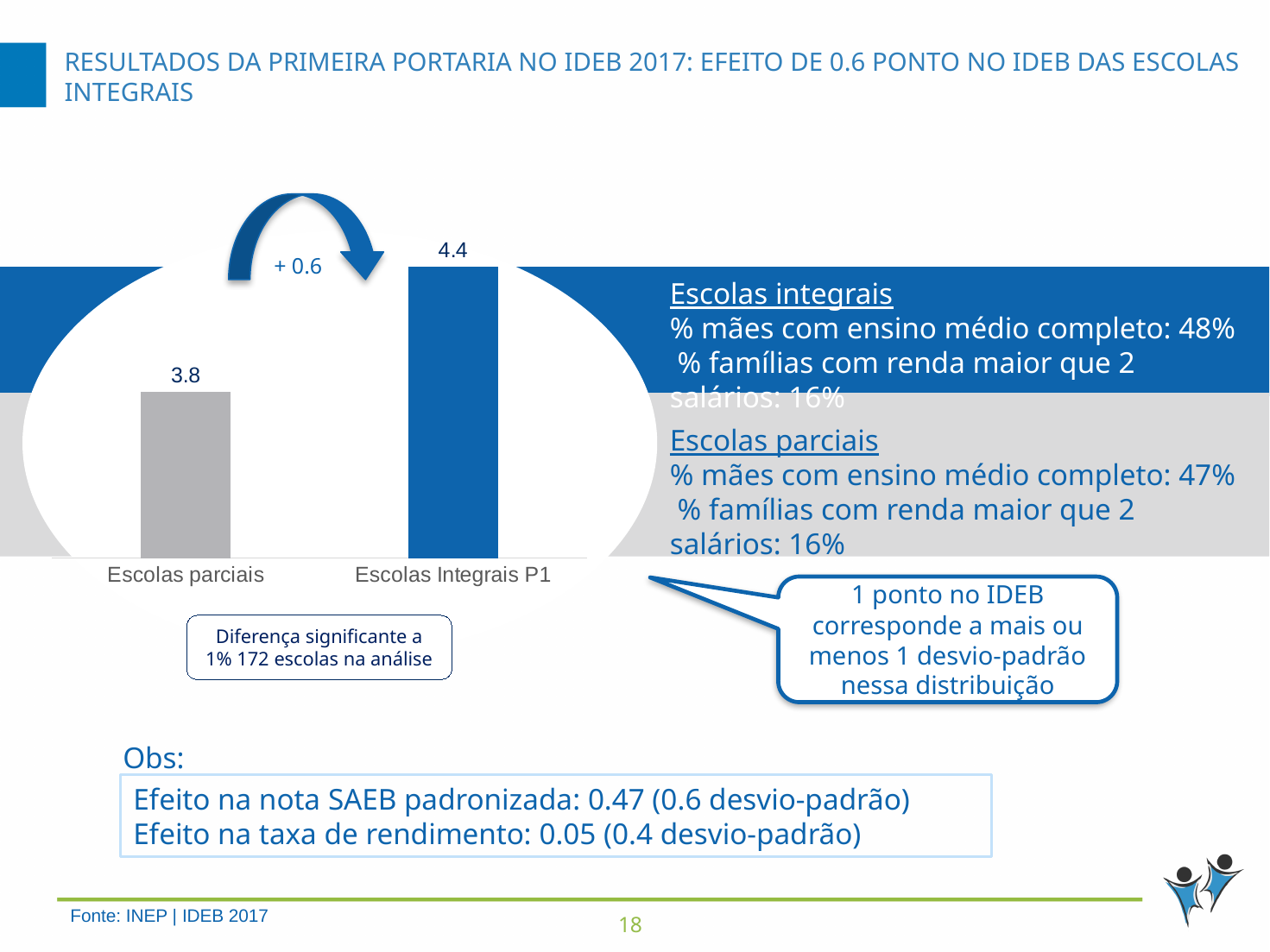
What is the value for Escolas parciais? 3.8 Which is larger, the value for Escolas parciais or the value for Escolas Integrais P1? Escolas Integrais P1 Do the values rise or fall from Escolas parciais to Escolas Integrais P1? Rise What kind of chart is shown on the slide? Bar chart What colour is the bar for Escolas Integrais P1? Blue What difference is indicated by the arrow above the bars? + 0.6 How many categories are shown in the chart? 2 What is the difference between the values for Escolas Integrais P1 and Escolas parciais? 0.6 Which category has the lowest value? Escolas parciais What is the value for Escolas Integrais P1? 4.4 Which category has the highest value? Escolas Integrais P1